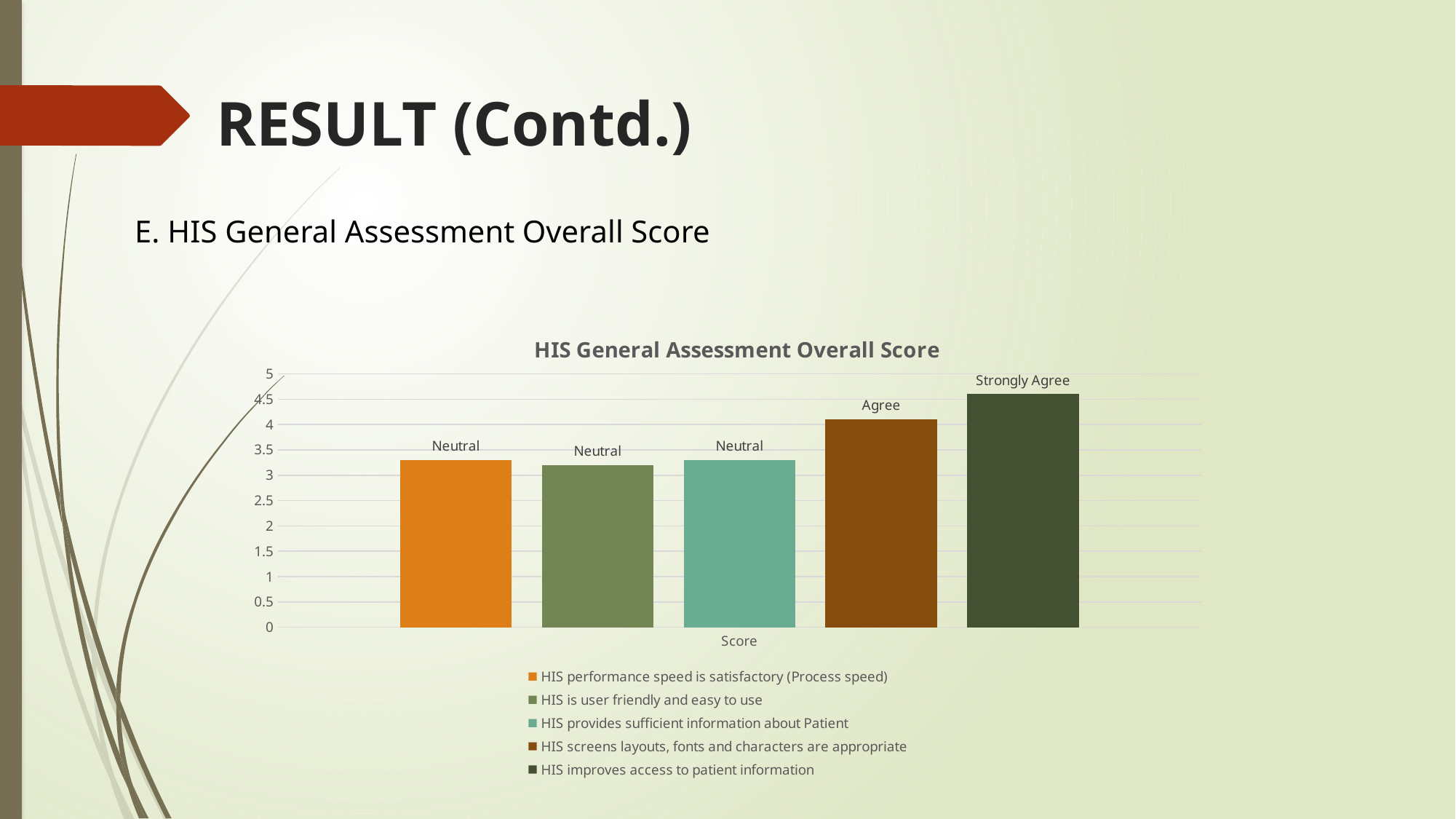
What data label is shown above the bar for 'HIS performance speed is satisfactory (Process speed)'? Neutral Is the value for 'HIS is user friendly and easy to use' greater or less than 3.5? less How many series does the legend list? 5 What kind of chart is shown on the slide? bar chart Is the value for 'HIS improves access to patient information' greater or less than 4? greater Is the value for 'HIS screens layouts, fonts and characters are appropriate' greater or less than 4.5? less What is the title of the chart? HIS General Assessment Overall Score Which series has the highest bar? HIS improves access to patient information What data label is shown above the bar for 'HIS improves access to patient information'? Strongly Agree How many categories are shown on the x axis? 1 What data label is shown above the bar for 'HIS screens layouts, fonts and characters are appropriate'? Agree Which is larger: the value for 'HIS screens layouts, fonts and characters are appropriate' or the value for 'HIS provides sufficient information about Patient'? HIS screens layouts, fonts and characters are appropriate